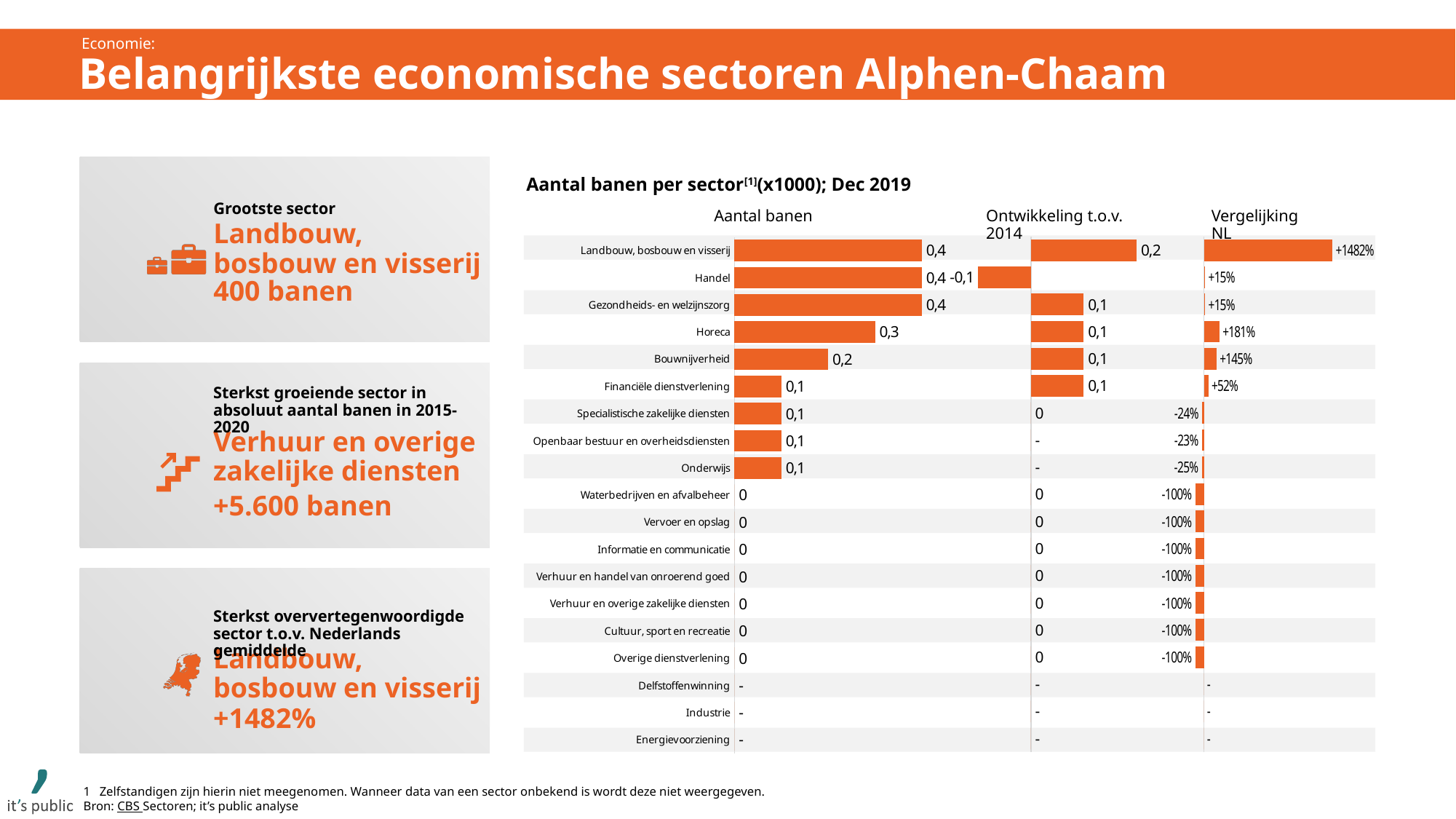
Which has more 'Aantal banen': Horeca or Bouwnijverheid? Horeca Which sector has the lowest 'Ontwikkeling t.o.v. 2014' value? Handel What is the 'Vergelijking NL' value for Financiële dienstverlening? +52% What is the 'Ontwikkeling t.o.v. 2014' value for Handel? -0,1 What is the 'Vergelijking NL' value for Landbouw, bosbouw en visserij? +1482% Which sector has the highest 'Vergelijking NL' value? Landbouw, bosbouw en visserij What is the 'Vergelijking NL' value for Bouwnijverheid? +145% What is the title of the chart? Aantal banen per sector (x1000); Dec 2019 What kind of chart is used to show the values per sector? Bar chart What is the value in the 'Aantal banen' column for Horeca? 0,3 What is the difference in 'Aantal banen' between Landbouw, bosbouw en visserij and Bouwnijverheid? 0,2 How many sectors are listed in the chart? 19